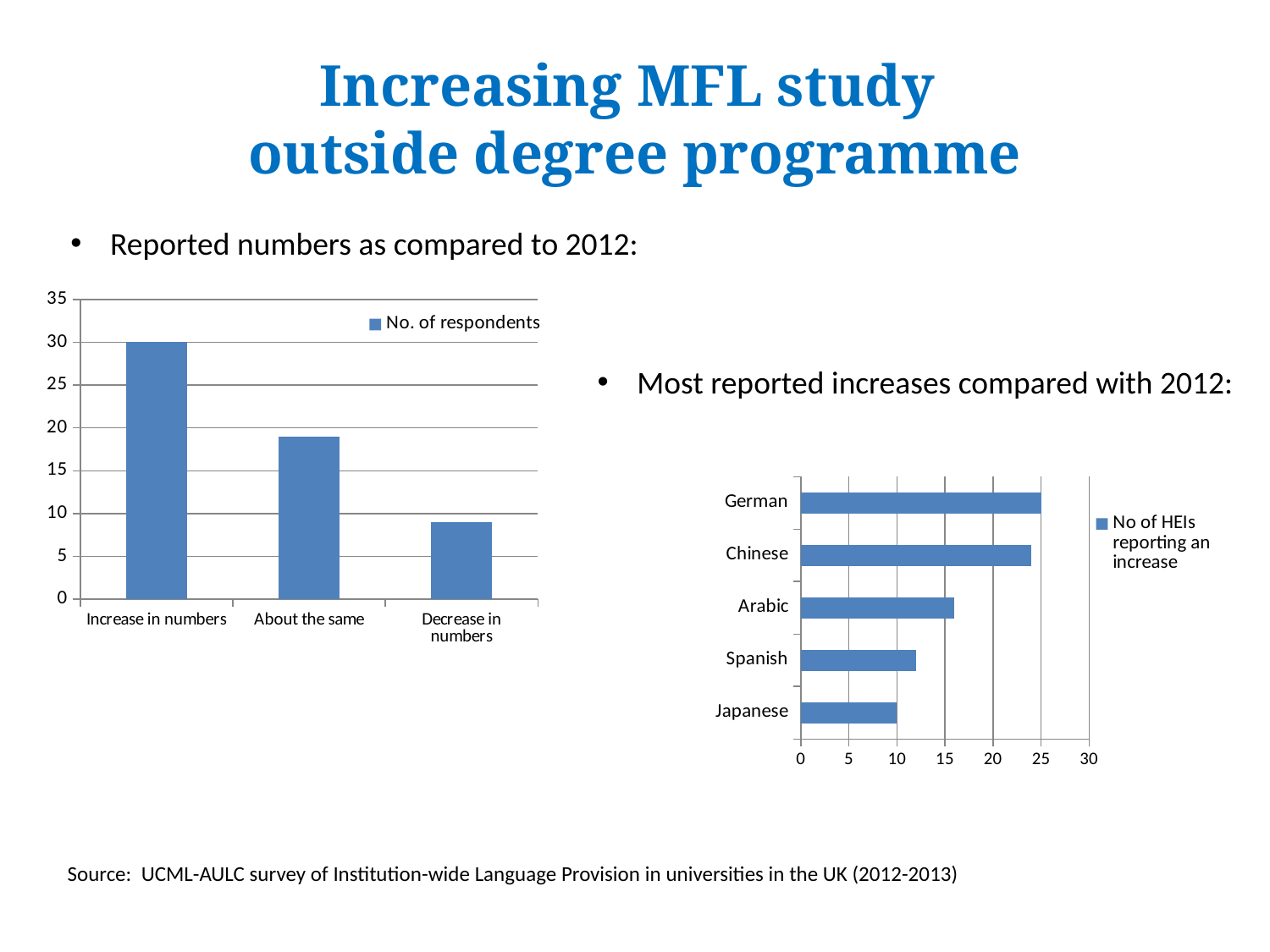
On the right chart, which is larger, the value for Chinese or the value for Spanish? Chinese On the left chart, what is the value for Increase in numbers? 30 On the right chart, is the value for Arabic greater or less than 15? greater How many categories are shown on the left chart? 3 On the right chart, what is the value for Japanese? 10 What type of chart is the right chart? Bar chart On the right chart, what is the value for German? 25 On the left chart, which category has the highest value? Increase in numbers On the left chart, is the value for Decrease in numbers greater or less than 10? less On the left chart, is the value for About the same greater or less than 15? greater On the right chart, which language has the lowest number of HEIs reporting an increase? Japanese On the left chart, which category has the lowest value? Decrease in numbers